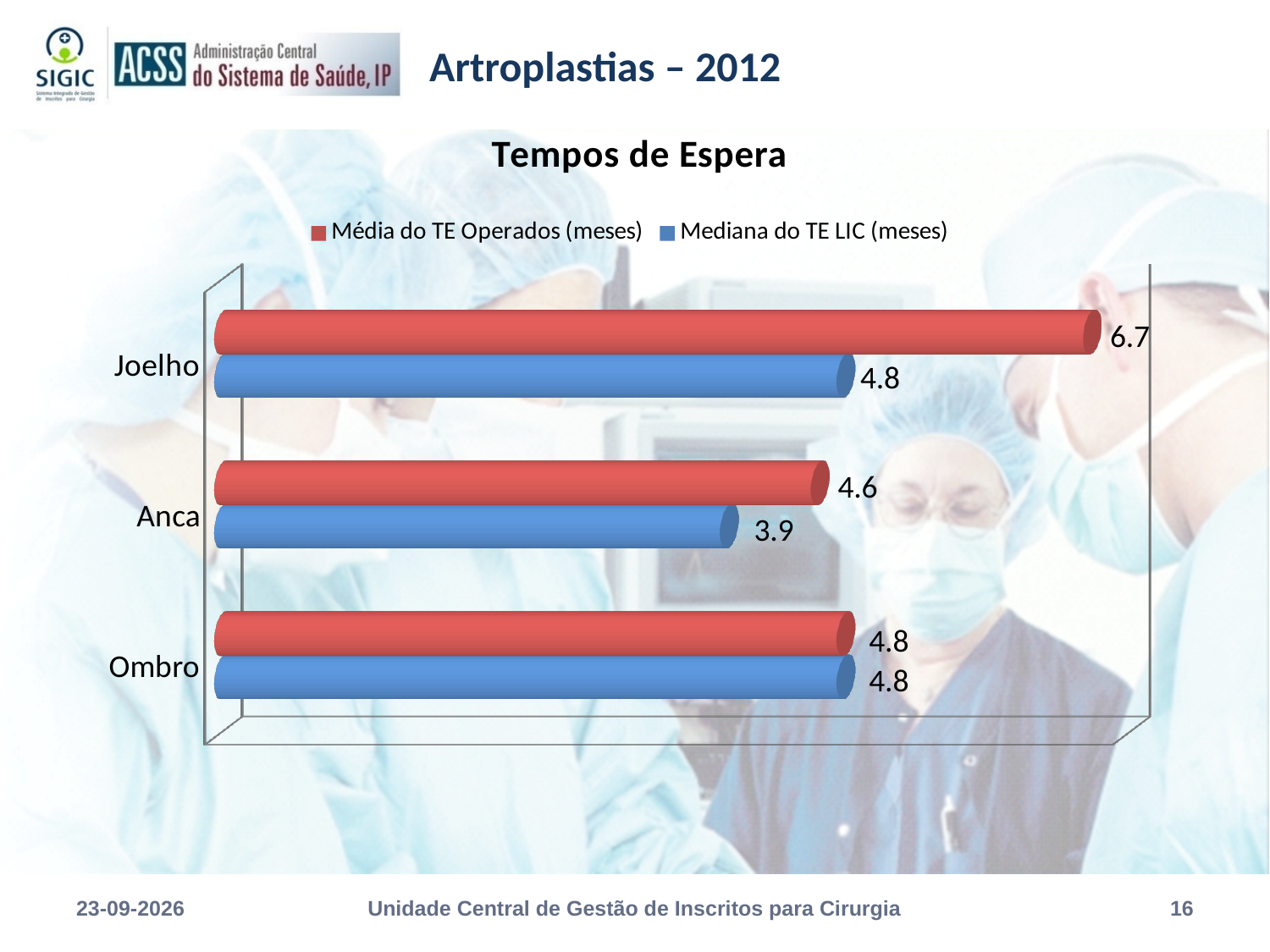
What is the Média do TE Operados (meses) value for Joelho? 6.7 Which category has the lowest Mediana do TE LIC (meses) value? Anca What is the difference between the Média do TE Operados and the Mediana do TE LIC for Anca? 0.7 What type of chart is shown on the slide? Bar chart Which is larger for Anca: the Média do TE Operados or the Mediana do TE LIC? Média do TE Operados What is the Mediana do TE LIC (meses) value for Anca? 3.9 What is the Média do TE Operados (meses) value for Ombro? 4.8 What is the difference between the Média do TE Operados and the Mediana do TE LIC for Joelho? 1.9 How many categories are shown on the chart? 3 How many series does the legend list? 2 What is the Mediana do TE LIC (meses) value for Joelho? 4.8 Which category has the highest Média do TE Operados (meses) value? Joelho